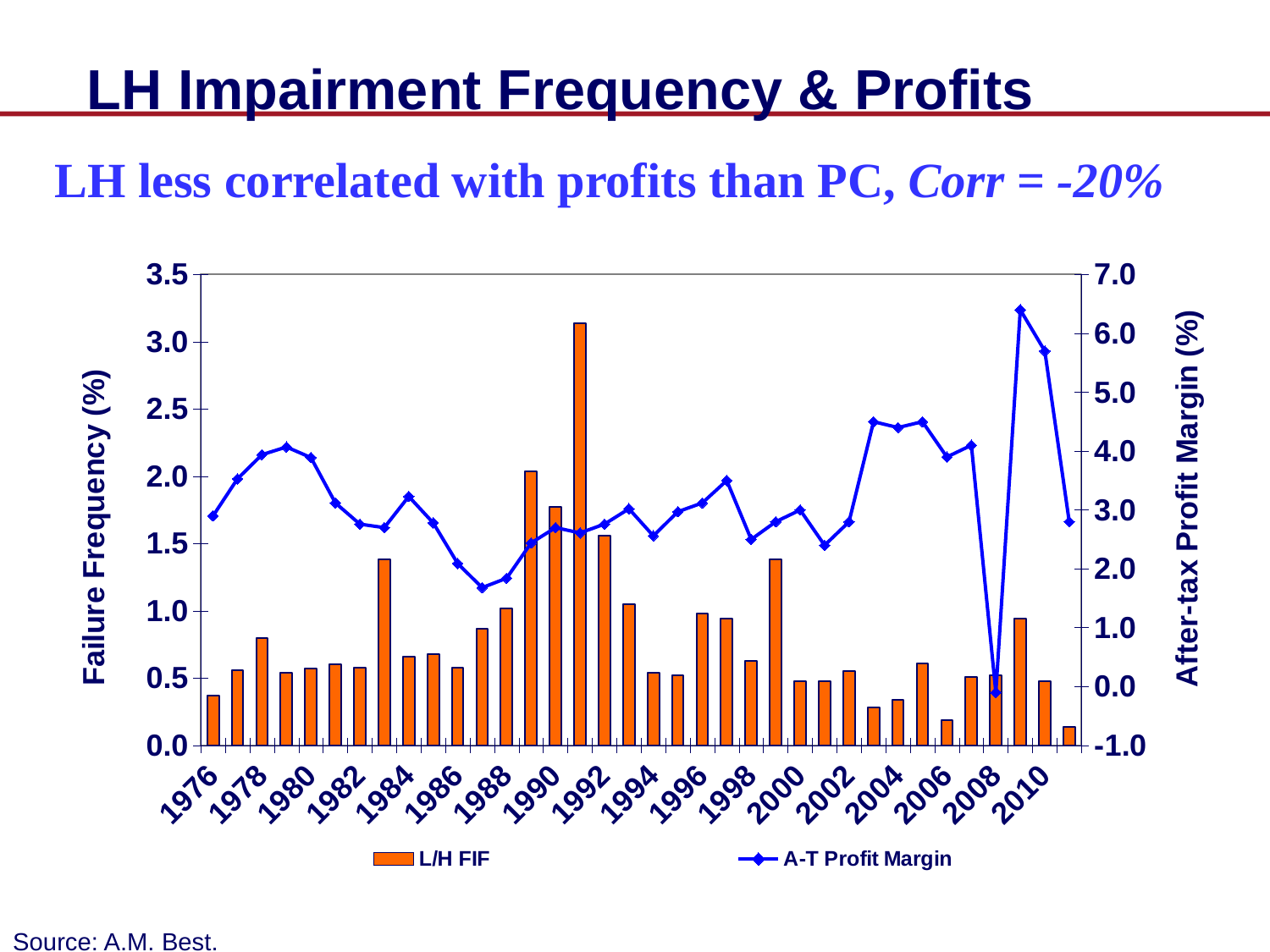
Is the A-T Profit Margin value for 2009 greater or less than 6.0? greater In which year is the L/H FIF bar the highest? 1991 How many series does the legend list? 2 Is the L/H FIF value for 2006 greater or less than 0.5? less In which year does the A-T Profit Margin line reach its highest point? 2009 Which year has the larger L/H FIF bar, 1989 or 1990? 1989 What kind of chart is shown on the slide? A combined bar and line chart Which series is plotted as bars? L/H FIF What is the title of the right-hand vertical axis? After-tax Profit Margin (%) Is the L/H FIF value for 1991 greater or less than 3.0? greater In which year does the A-T Profit Margin line reach its lowest point? 2008